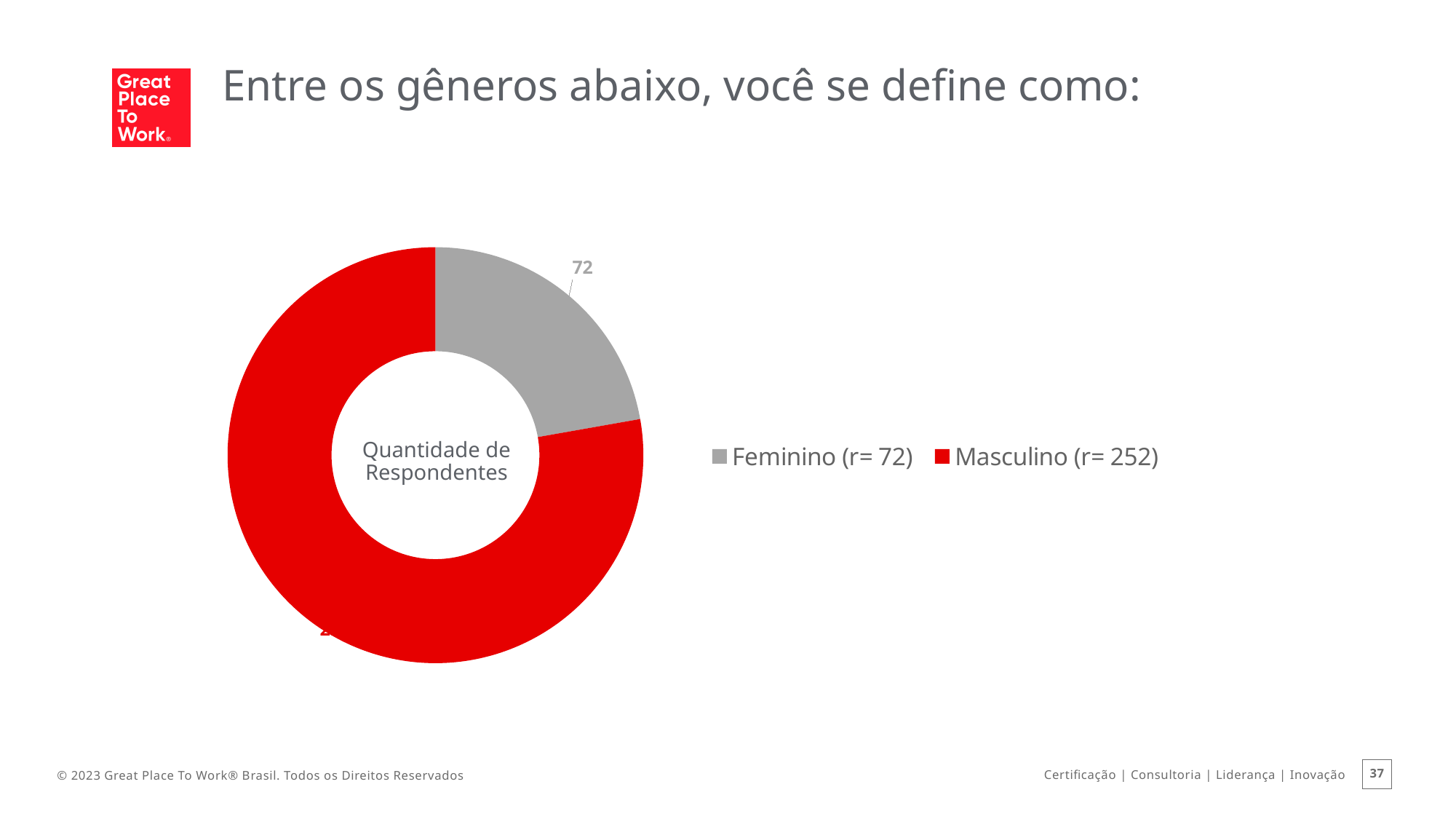
How many respondents identified as Masculino? 252 What is the total number of respondents shown in the chart? 324 Which is larger, the number of Feminino respondents or the number of Masculino respondents? Masculino What text appears in the centre of the donut chart? Quantidade de Respondentes What is the difference between the number of Masculino and Feminino respondents? 180 Which gender category has the largest slice of the chart? Masculino Which gender category has the smallest slice of the chart? Feminino How many categories does the chart show? 2 What share of respondents identified as Feminino? 22.2% What colour represents Masculino in the chart? Red How many respondents identified as Feminino? 72 What kind of chart is shown on the slide? Pie chart (donut)